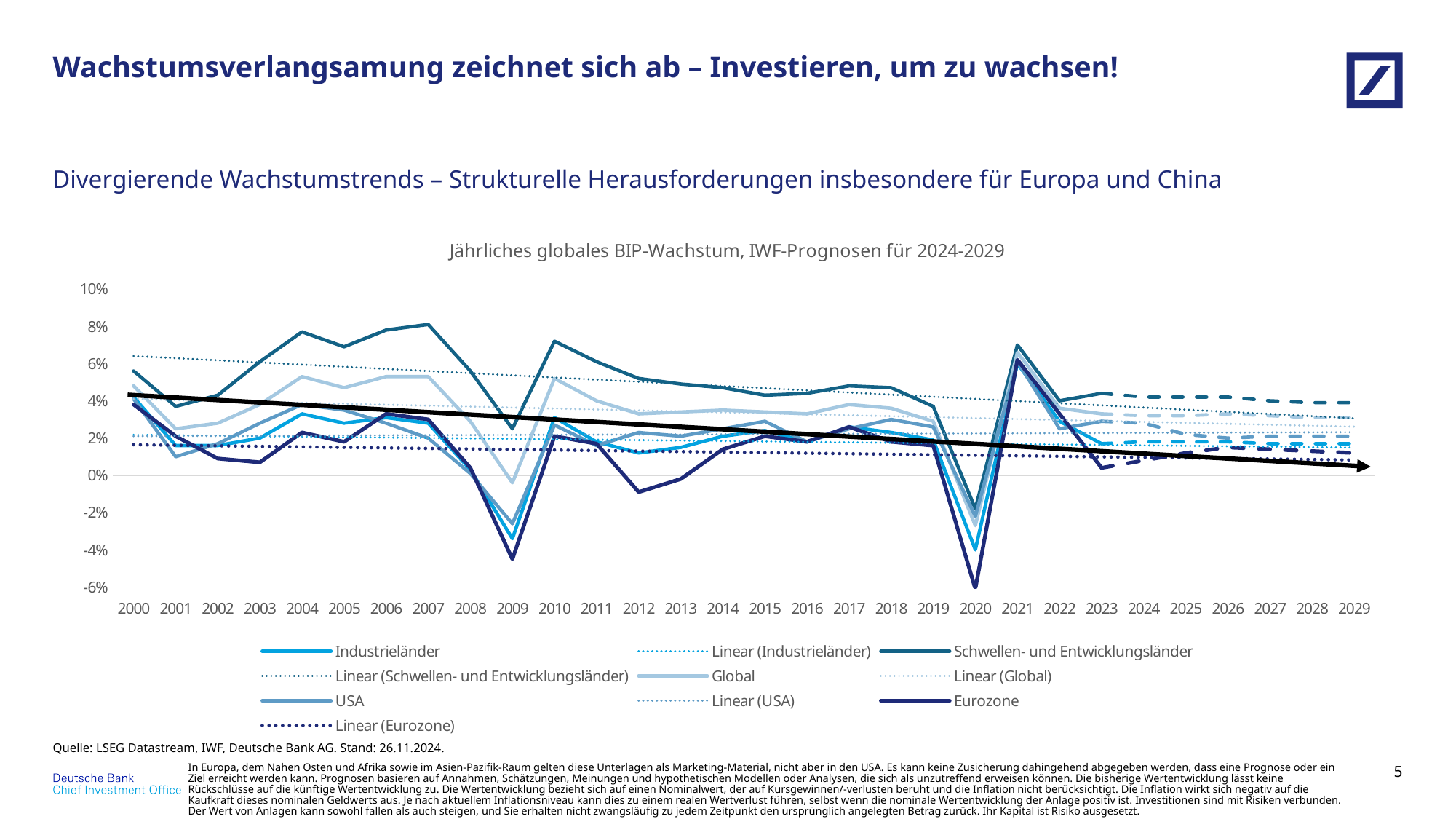
Which series has the lowest value in 2020? Eurozone Is the value for Schwellen- und Entwicklungsländer in 2020 greater or less than 0%? less Is the value for Schwellen- und Entwicklungsländer in 2007 greater or less than 6%? greater Which series has the highest value in 2007? Schwellen- und Entwicklungsländer What is the title of the chart? Jährliches globales BIP-Wachstum, IWF-Prognosen für 2024-2029 How many years are shown on the x axis of the chart? 30 In 2021, which is higher: Schwellen- und Entwicklungsländer or Industrieländer? Schwellen- und Entwicklungsländer Does the black arrow trend line rise or fall from 2000 to 2029? fall How many entries does the chart legend list? 10 What kind of chart is shown on the slide? line chart Is the value for Eurozone in 2020 greater or less than -4%? less